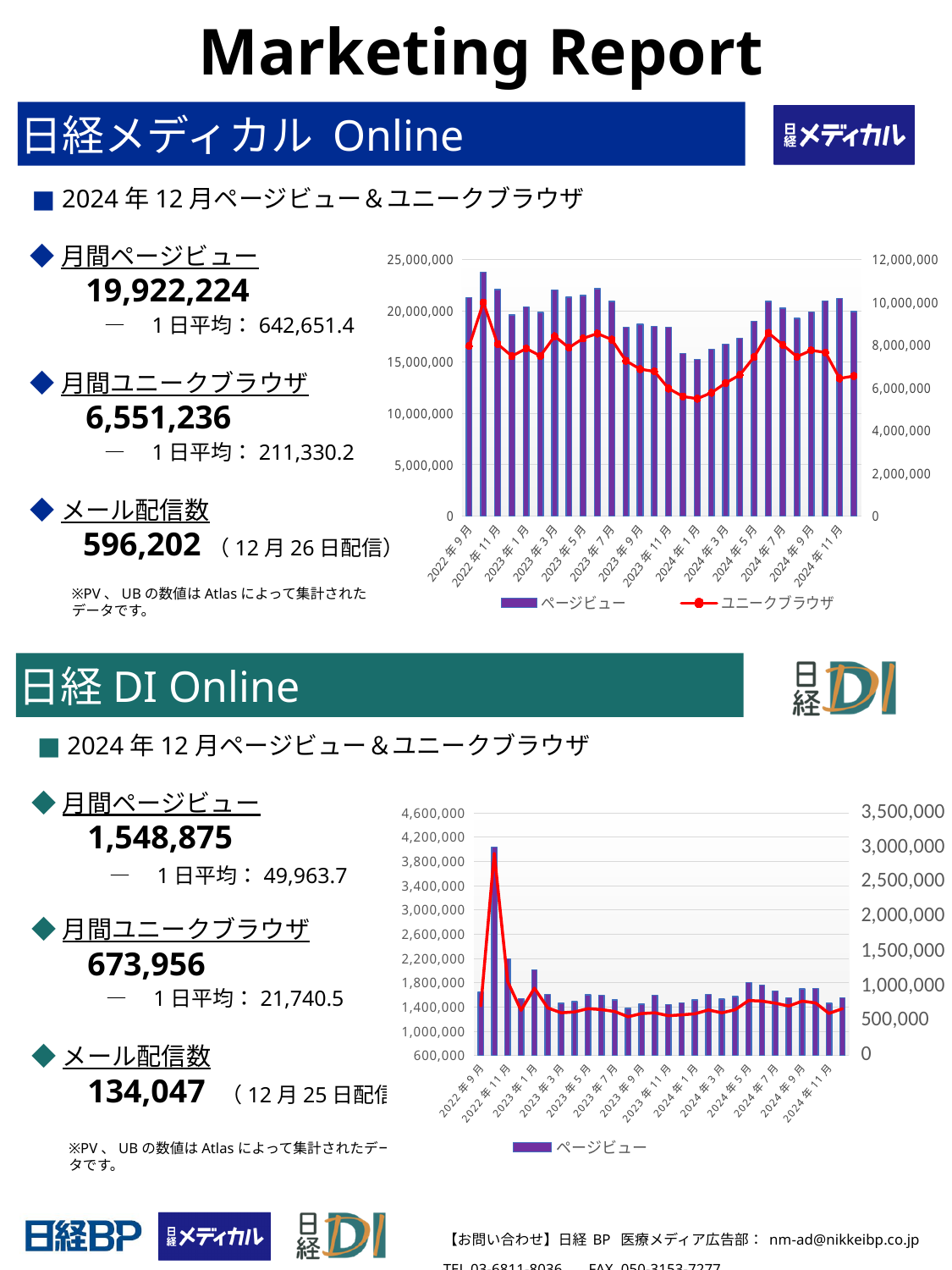
In the 日経 DI Online chart (bottom chart), which is larger, the ページビュー bar for 2022年11月 or for 2024年11月? 2022年11月 In the 日経 DI Online chart (bottom chart), is the ページビュー value for 2022年11月 greater or less than 3,400,000? less What is the maximum value shown on the left axis of the 日経 DI Online chart (bottom chart)? 4,600,000 In the 日経 DI Online chart (bottom chart), which month has the highest ページビュー bar? 2022年10月 In the 日経メディカル Online chart (top chart), is the ページビュー value for 2022年11月 greater or less than 20,000,000? greater In the 日経メディカル Online chart (top chart), do the ユニークブラウザ values rise or fall from 2023年7月 to 2024年1月? fall In the 日経メディカル Online chart (top chart), which month has the highest ページビュー bar? 2022年10月 In the 日経メディカル Online chart (top chart), is the ページビュー value for 2024年1月 greater or less than 20,000,000? less How many series does the legend of the 日経メディカル Online chart (top chart) list? 2 What kind of chart is the 日経メディカル Online chart (top chart)? Combined bar and line chart In the 日経メディカル Online chart (top chart), which is larger, the ページビュー bar for 2022年11月 or for 2024年1月? 2022年11月